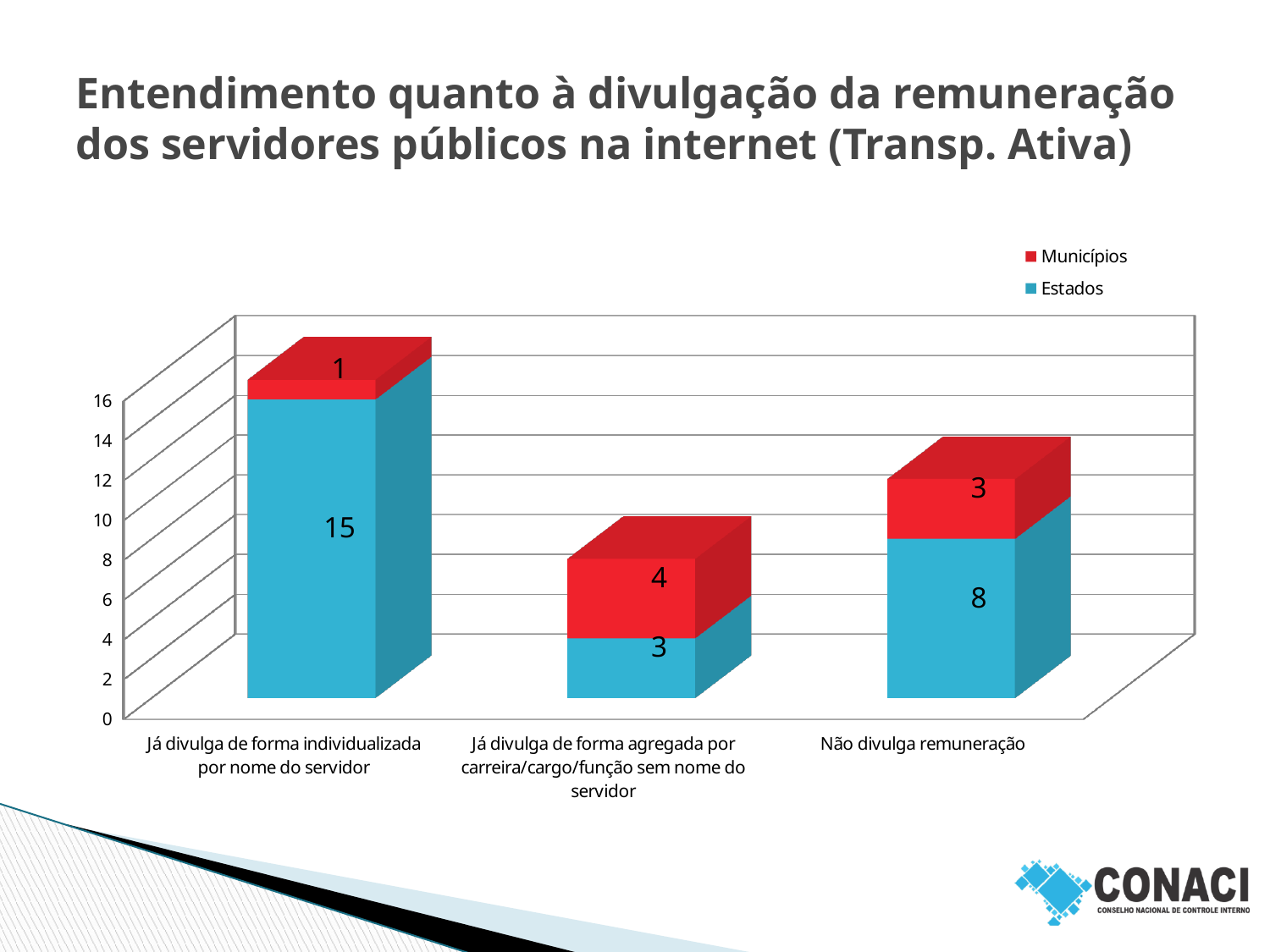
Which is larger: the Municípios value for 'Já divulga de forma agregada por carreira/cargo/função sem nome do servidor' or for 'Não divulga remuneração'? Já divulga de forma agregada por carreira/cargo/função sem nome do servidor What is the Municípios value for 'Já divulga de forma agregada por carreira/cargo/função sem nome do servidor'? 4 Which category has the highest Estados value? Já divulga de forma individualizada por nome do servidor What is the difference between the Estados values for 'Já divulga de forma individualizada por nome do servidor' and 'Não divulga remuneração'? 7 What is the Municípios value for 'Não divulga remuneração'? 3 How many series does the legend list? 2 What is the Estados value for 'Não divulga remuneração'? 8 Which category has the lowest Municípios value? Já divulga de forma individualizada por nome do servidor What is the total of the stacked bar for 'Não divulga remuneração'? 11 What is the total of the stacked bar for 'Já divulga de forma agregada por carreira/cargo/função sem nome do servidor'? 7 What kind of chart is shown on the slide? Stacked bar chart What is the Estados value for 'Já divulga de forma individualizada por nome do servidor'? 15